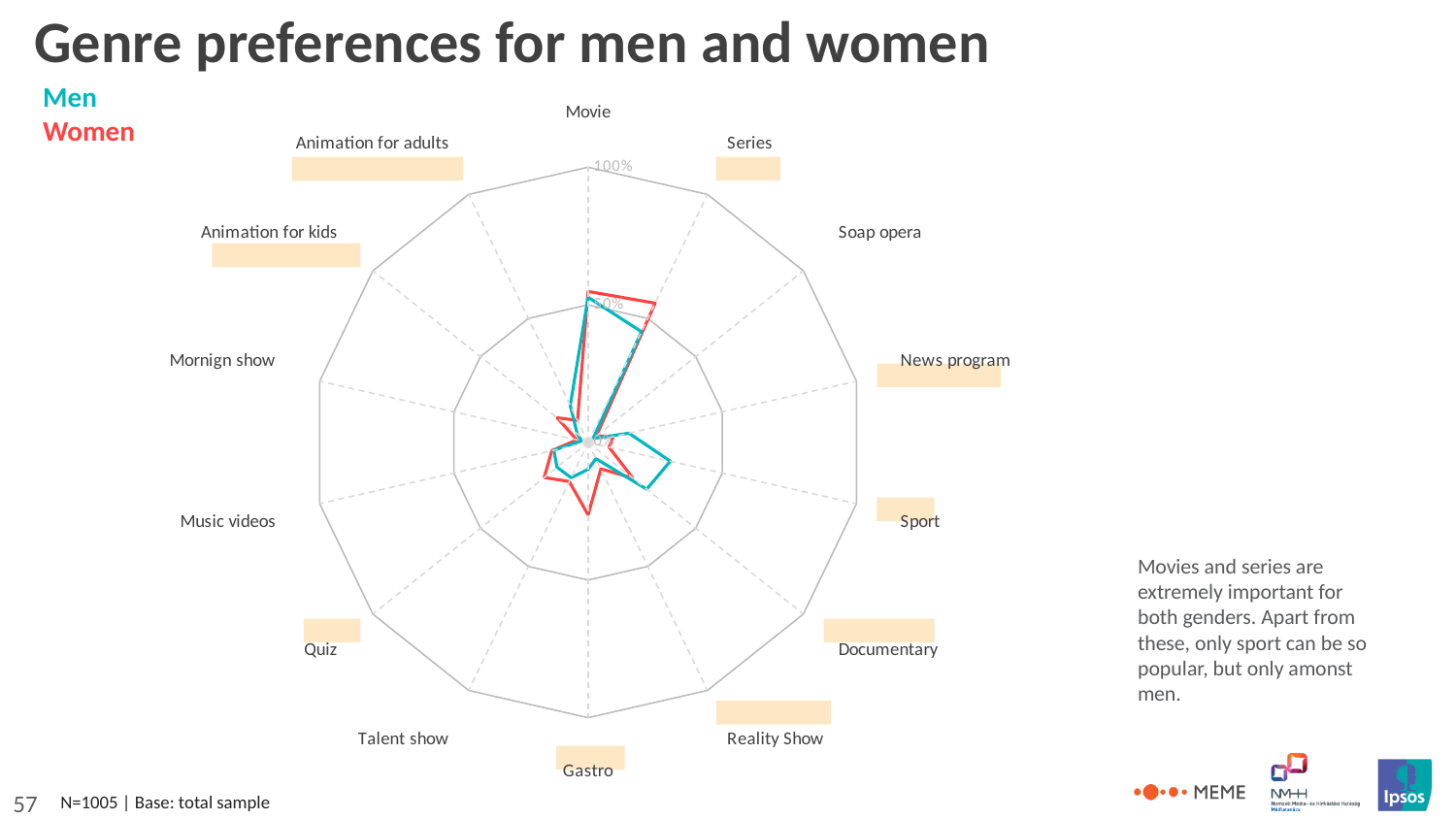
Which two series are shown in the chart? Men and Women Is the value for Sport among Men greater or less than 50%? less Is the value for Gastro among Women greater or less than 50%? less What is the title of the slide's chart? Genre preferences for men and women For Sport, which series has the larger value, Men or Women? Men Is the value for Sport among Women greater or less than 50%? less For Documentary, which series has the larger value, Men or Women? Men How many genre categories are plotted on the radar chart? 14 What kind of chart is shown on the slide? Radar chart For Gastro, which series has the larger value, Men or Women? Women How many series does the legend list? 2